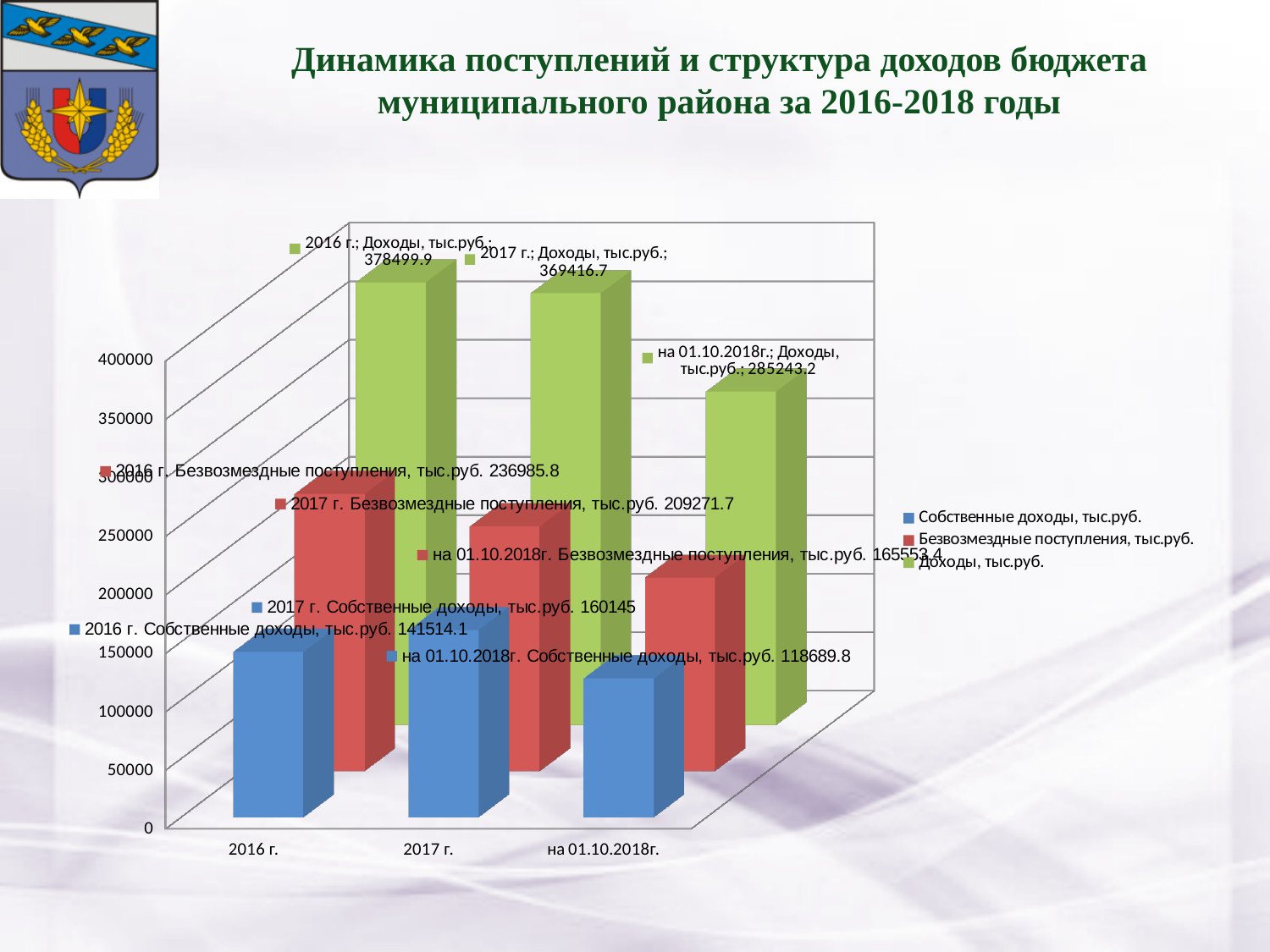
What is the difference between Доходы, тыс.руб. for 2016 г. and for 2017 г.? 9083.2 Which category has the lowest value for Доходы, тыс.руб.? на 01.10.2018г. Does the value of Безвозмездные поступления, тыс.руб. rise or fall from 2016 г. to на 01.10.2018г.? Fall What is the value of Собственные доходы, тыс.руб. for 2017 г.? 160145 What is the value of Доходы, тыс.руб. for 2016 г.? 378499.9 What is the value of Доходы, тыс.руб. for на 01.10.2018г.? 285243.2 What is the value of Безвозмездные поступления, тыс.руб. for на 01.10.2018г.? 165553.4 What kind of chart is shown on the slide? Bar chart How many series does the legend list? 3 How many categories are shown on the x axis? 3 Which is larger: Безвозмездные поступления, тыс.руб. for 2016 г. or for 2017 г.? 2016 г. Which category has the highest value for Собственные доходы, тыс.руб.? 2017 г.